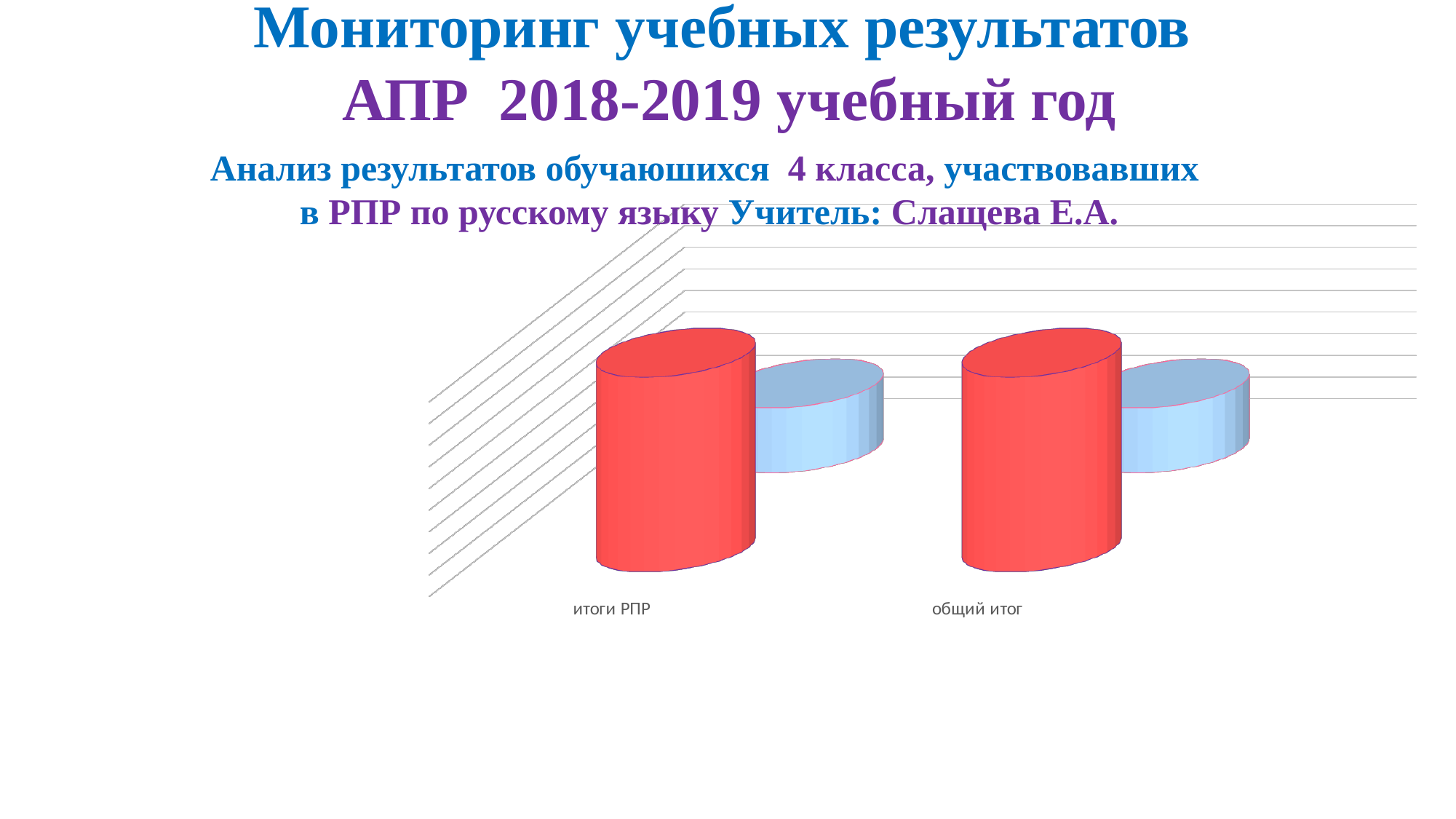
What is the label of the first (left) category on the x axis? итоги РПР In the category "итоги РПР", which bar is taller, the red one or the blue one? the red one How many categories are shown on the x axis of the chart? 2 In the category "общий итог", which bar is taller, the red one or the blue one? the red one In the category "общий итог", is the blue bar higher or lower than the red bar? lower What are the two category labels on the x axis of the chart? итоги РПР, общий итог What kind of chart is shown on the slide? bar chart